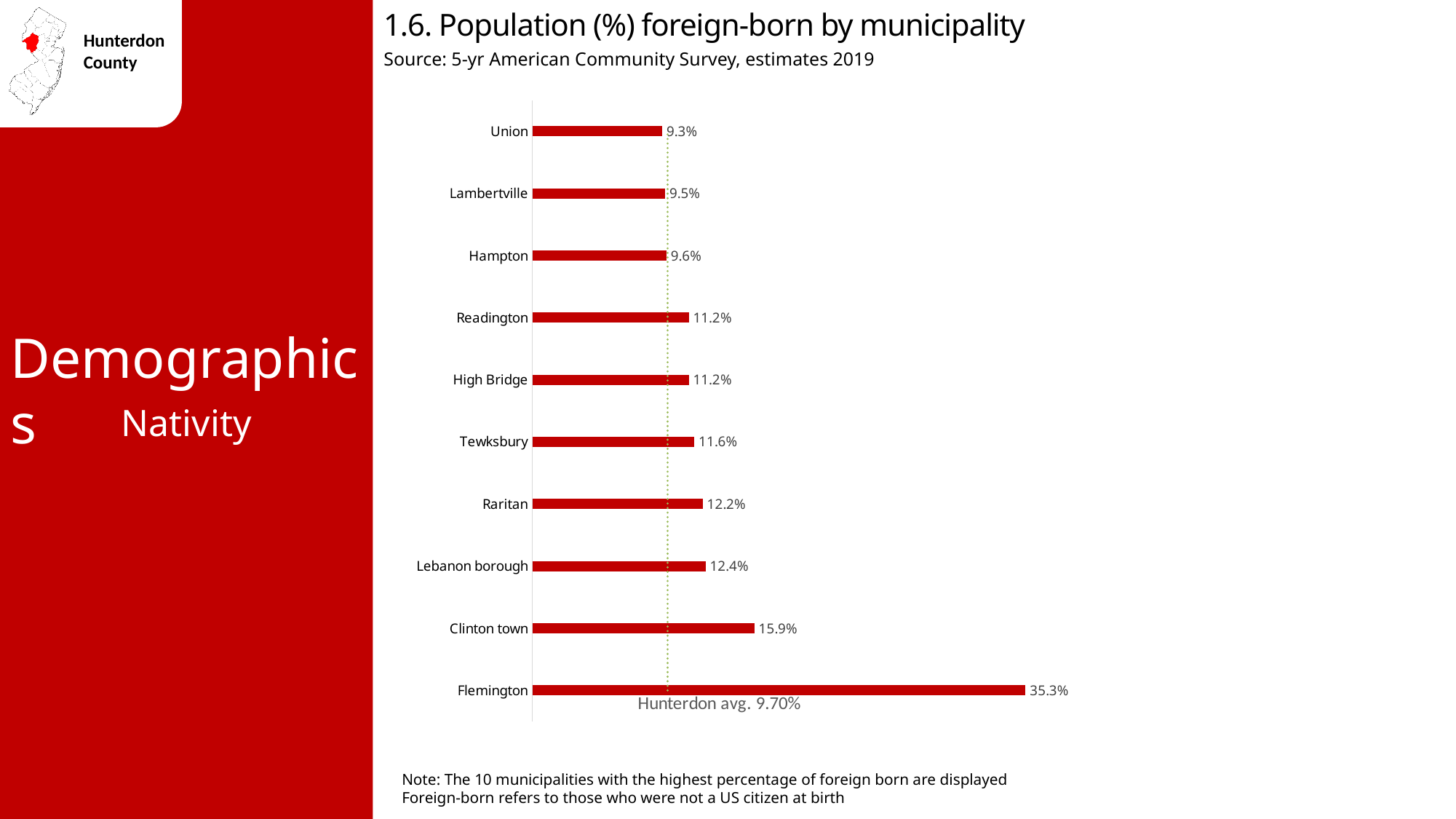
What is the difference between the foreign-born percentages of Lambertville and Union? 0.2% What is the difference between the foreign-born percentages of Flemington and Clinton town? 19.4% What is the percentage of foreign-born population in Flemington? 35.3% What is the percentage of foreign-born population in Tewksbury? 11.6% What is the source of the data shown in the chart? 5-yr American Community Survey, estimates 2019 What type of chart is used to show the foreign-born population by municipality? Bar chart Which municipality has the lowest percentage of foreign-born population shown on the chart? Union What is the percentage of foreign-born population in Clinton town? 15.9% What is the Hunterdon County average foreign-born percentage marked on the chart? 9.70% Which has a higher foreign-born percentage, Raritan or Lebanon borough? Lebanon borough Which municipality has the highest percentage of foreign-born population? Flemington How many municipalities are shown on the chart? 10